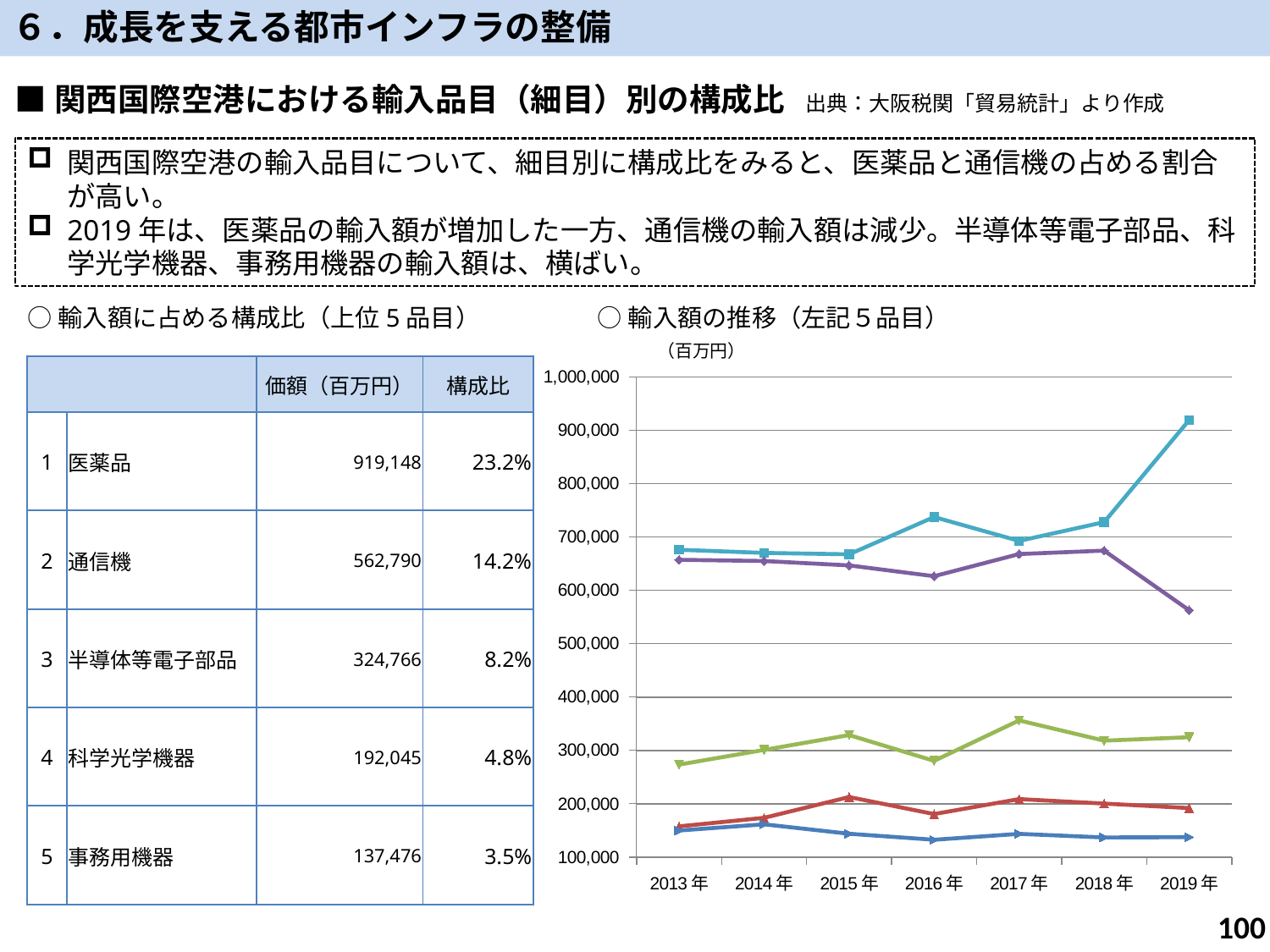
In the line chart, which line has the lowest value in 2019年? the dark blue line In the line chart, is the value of the light blue line in 2019年 greater or less than 900,000? greater How many lines are plotted in the line chart? 5 In the line chart, is the value of the dark blue line in 2016年 greater or less than 200,000? less In the line chart, is the value of the green line in 2017年 greater or less than 300,000? greater What kind of chart is shown on the right side of the slide? line chart How many years are shown on the x axis of the line chart? 7 What is the title of the line chart? 輸入額の推移（左記５品目） In the line chart, does the light blue line rise or fall from 2018年 to 2019年? rise In the line chart, which line has the highest value in 2019年? the light blue line What unit is shown above the y axis of the line chart? 百万円